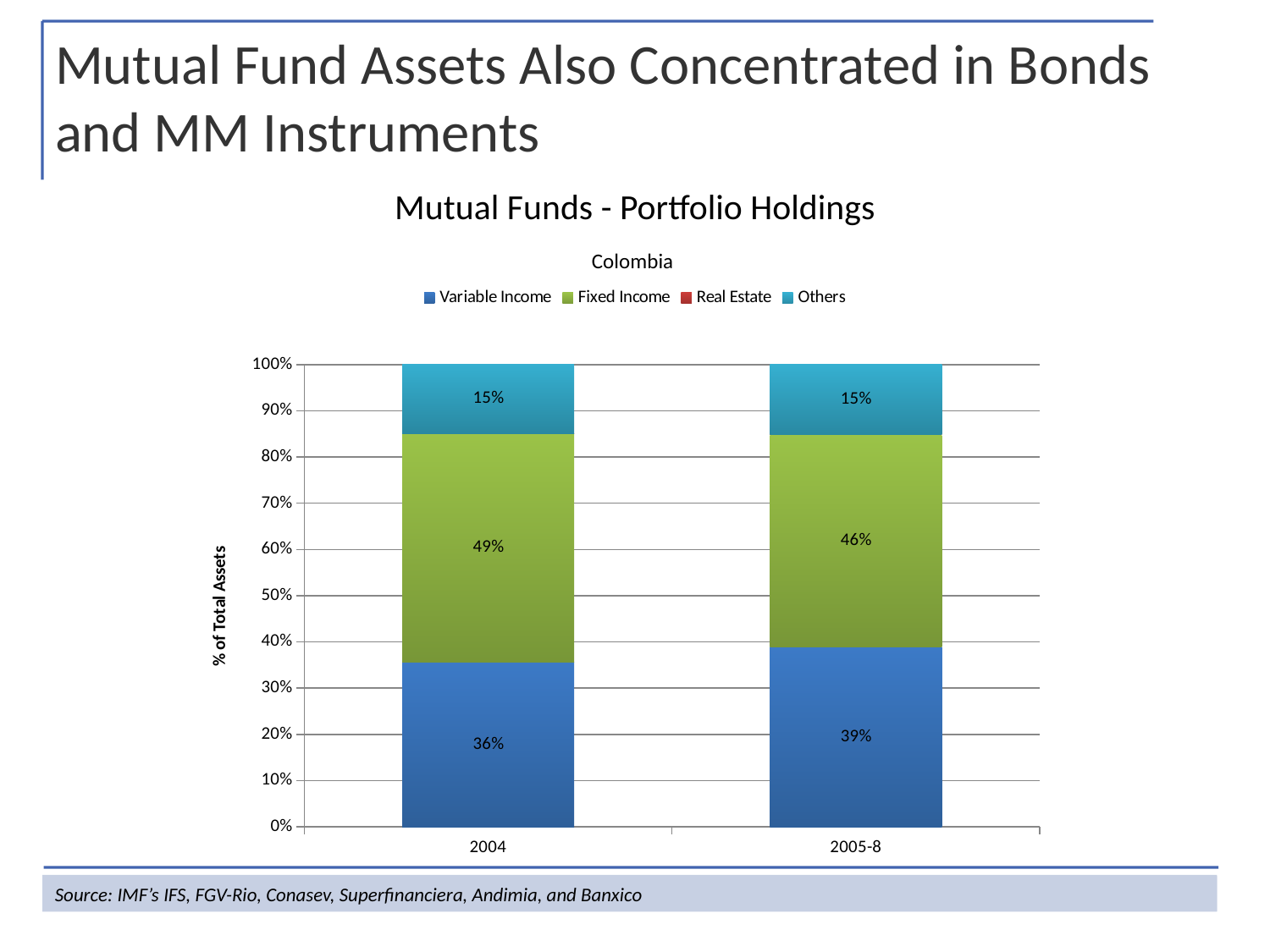
What is the Fixed Income share for 2005-8? 46% Which labelled series has the smallest share in 2005-8? Others Is the Variable Income share larger in 2004 or in 2005-8? 2005-8 How many categories are shown on the x axis? 2 Which series has the largest share in 2004? Fixed Income What is the Variable Income share for 2005-8? 39% What is the Others share for 2004? 15% What is the label of the vertical axis? % of Total Assets By how many percentage points did the Fixed Income share fall from 2004 to 2005-8? 3 percentage points How many series does the legend list? 4 What kind of chart is shown? Stacked bar chart What is the Fixed Income share for 2004? 49%